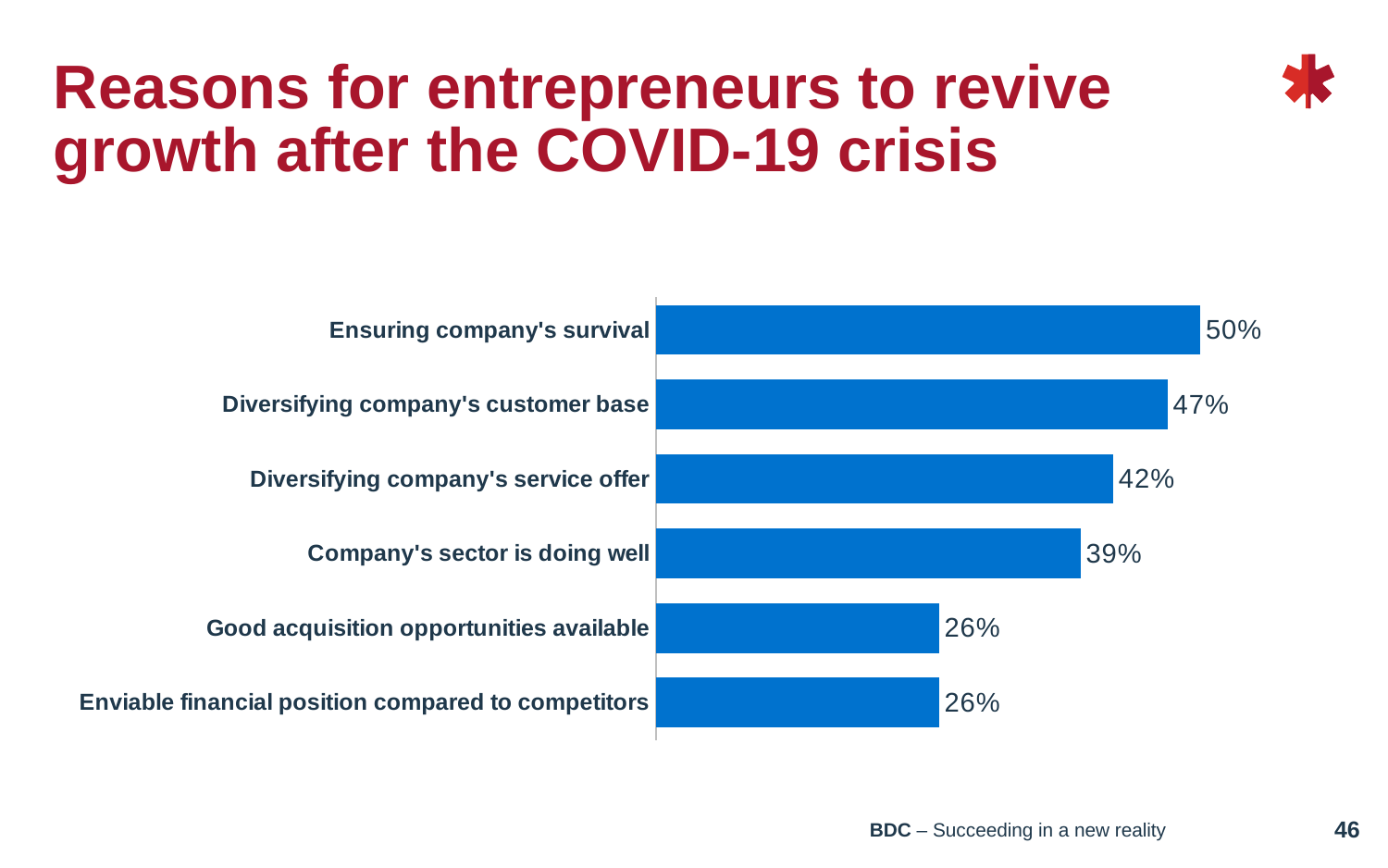
What is the value for good acquisition opportunities available? 26% How many reasons have a value of 26%? 2 What colour are the bars in the chart? Blue Which is larger: diversifying company's service offer or company's sector is doing well? Diversifying company's service offer What is the value for company's sector is doing well? 39% Which reason has the highest percentage? Ensuring company's survival How many reasons are shown in the chart? 6 What is the difference between ensuring company's survival and diversifying company's service offer? 8% What is the value for diversifying company's customer base? 47% What is the difference between diversifying company's customer base and company's sector is doing well? 8% What type of chart is shown on the slide? Bar chart What percentage of entrepreneurs cited ensuring company's survival as a reason to revive growth? 50%